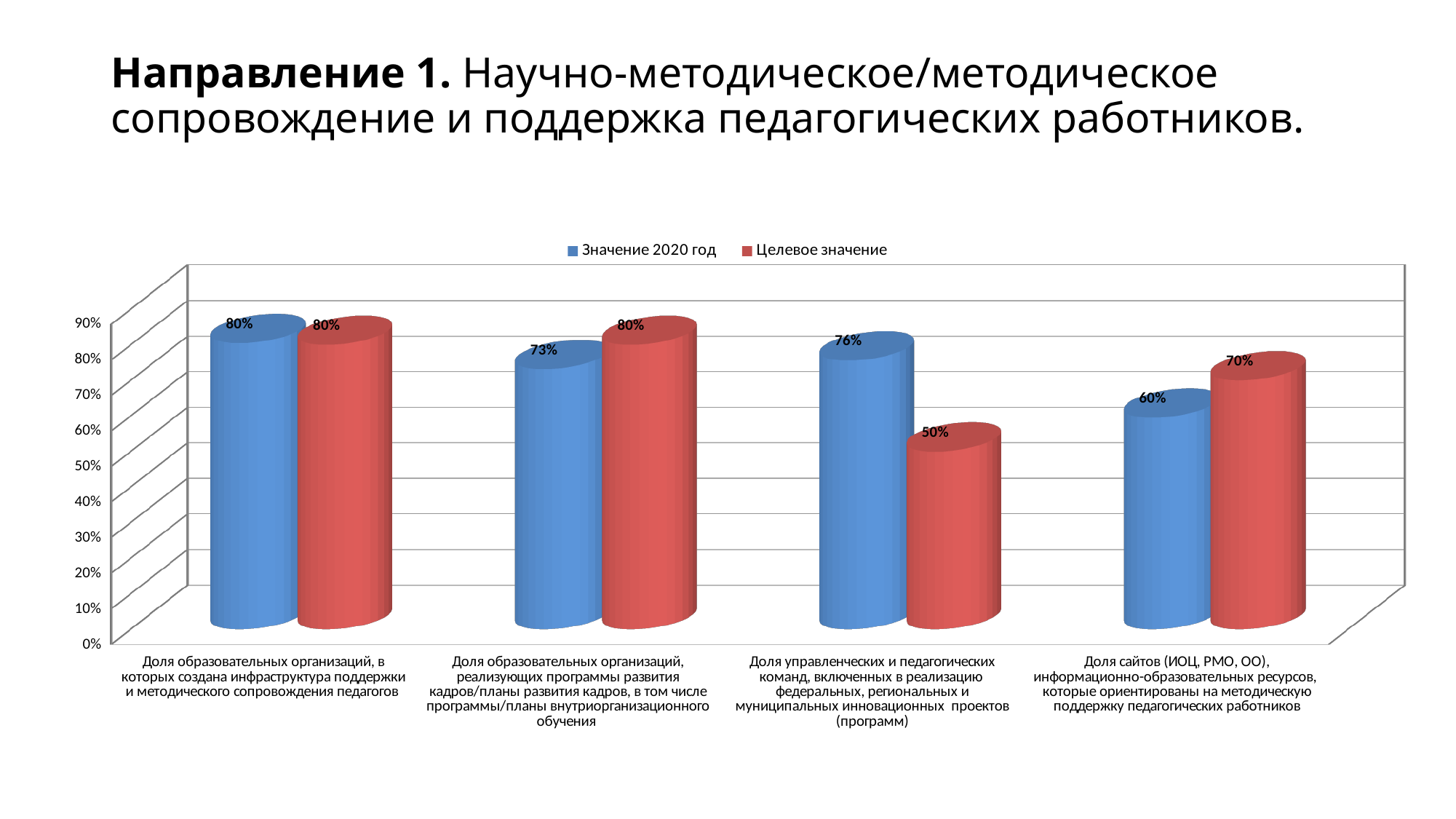
How many series does the chart legend list? 2 For 'Доля управленческих и педагогических команд...', which is larger: 'Значение 2020 год' or 'Целевое значение'? Значение 2020 год Which category has the lowest 'Значение 2020 год' value? Доля сайтов (ИОЦ, РМО, ОО), информационно-образовательных ресурсов, которые ориентированы на методическую поддержку педагогических работников What is the 'Целевое значение' for the category 'Доля управленческих и педагогических команд, включенных в реализацию ... инновационных проектов (программ)'? 50% What is the 'Целевое значение' for 'Доля образовательных организаций, в которых создана инфраструктура поддержки и методического сопровождения педагогов'? 80% What is the 'Значение 2020 год' value for the category 'Доля сайтов (ИОЦ, РМО, ОО), информационно-образовательных ресурсов...'? 60% What type of chart is shown on the slide? Bar chart Which category has the lowest 'Целевое значение'? Доля управленческих и педагогических команд, включенных в реализацию федеральных, региональных и муниципальных инновационных проектов (программ) What is the difference between the 'Целевое значение' and the 'Значение 2020 год' for 'Доля образовательных организаций, реализующих программы развития кадров...'? 7% For 'Доля сайтов (ИОЦ, РМО, ОО)...', which is larger: 'Значение 2020 год' or 'Целевое значение'? Целевое значение What is the 'Значение 2020 год' value for 'Доля образовательных организаций, реализующих программы развития кадров/планы развития кадров...'? 73% How many categories are shown on the x axis of the chart? 4